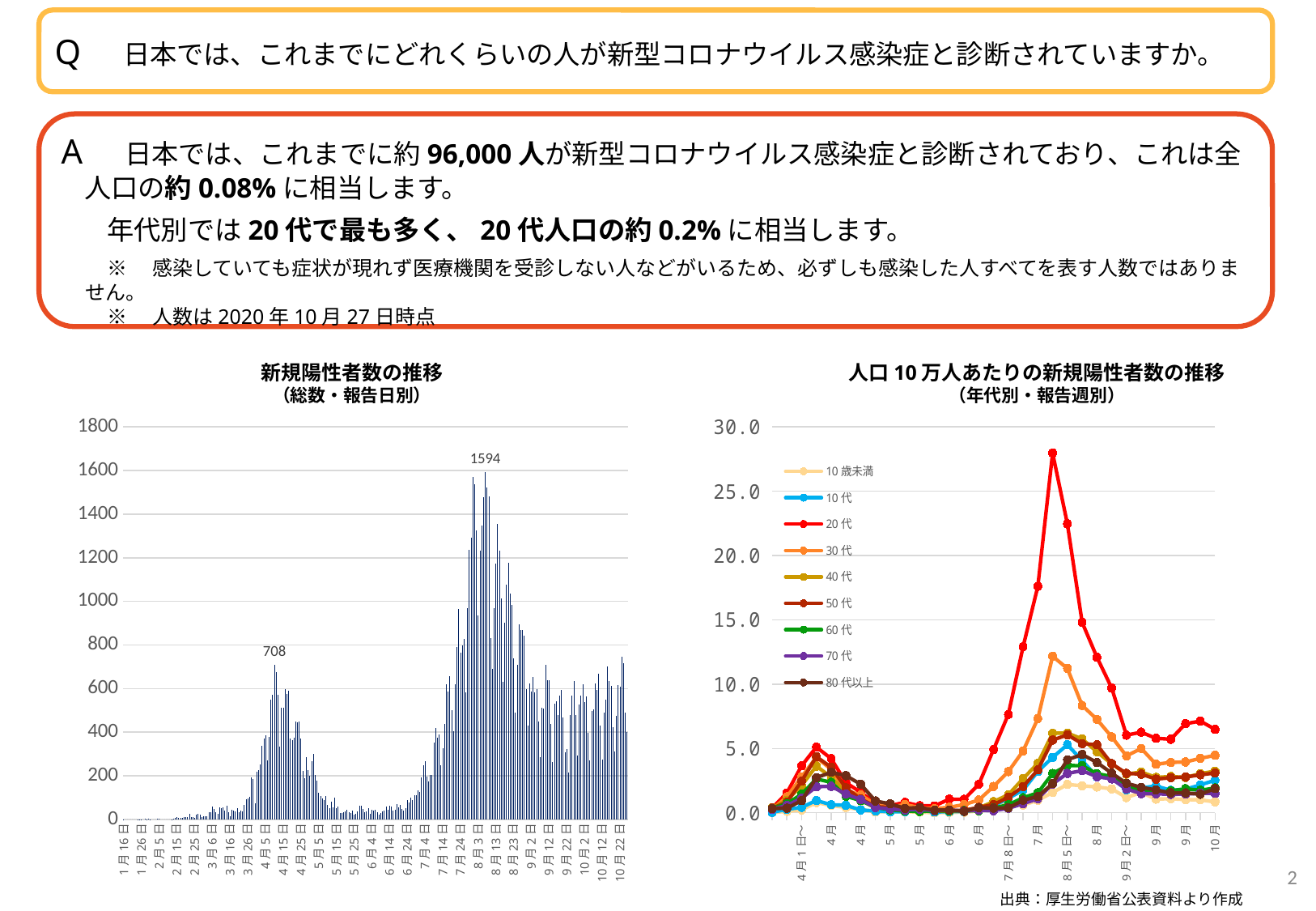
In the right chart 人口10万人あたりの新規陽性者数の推移, is the peak value for 20代 greater or less than 25.0? greater How many series does the legend of the right chart 人口10万人あたりの新規陽性者数の推移 list? 9 In the left chart 新規陽性者数の推移, what is the highest labelled daily value? 1594 What kind of chart is the right chart titled 人口10万人あたりの新規陽性者数の推移（年代別・報告週別）? line chart In the left chart 新規陽性者数の推移, what is the difference between the two labelled peaks, 1594 and 708? 886 In the left chart 新規陽性者数の推移, what value is labelled at the peak of the first wave in April? 708 In the right chart 人口10万人あたりの新規陽性者数の推移, which age group reaches the highest value? 20代 What kind of chart is the left chart titled 新規陽性者数の推移（総数・報告日別）? bar chart In the right chart 人口10万人あたりの新規陽性者数の推移, which series is higher at the early-August peak, 20代 or 30代? 20代 In the left chart 新規陽性者数の推移, which labelled peak is larger, the April peak or the August peak? the August peak (1594) In the left chart 新規陽性者数の推移, is the highest bar greater or less than 1800? less In the right chart 人口10万人あたりの新規陽性者数の推移, does the 20代 line rise or fall from 8月5日～ to 9月? fall